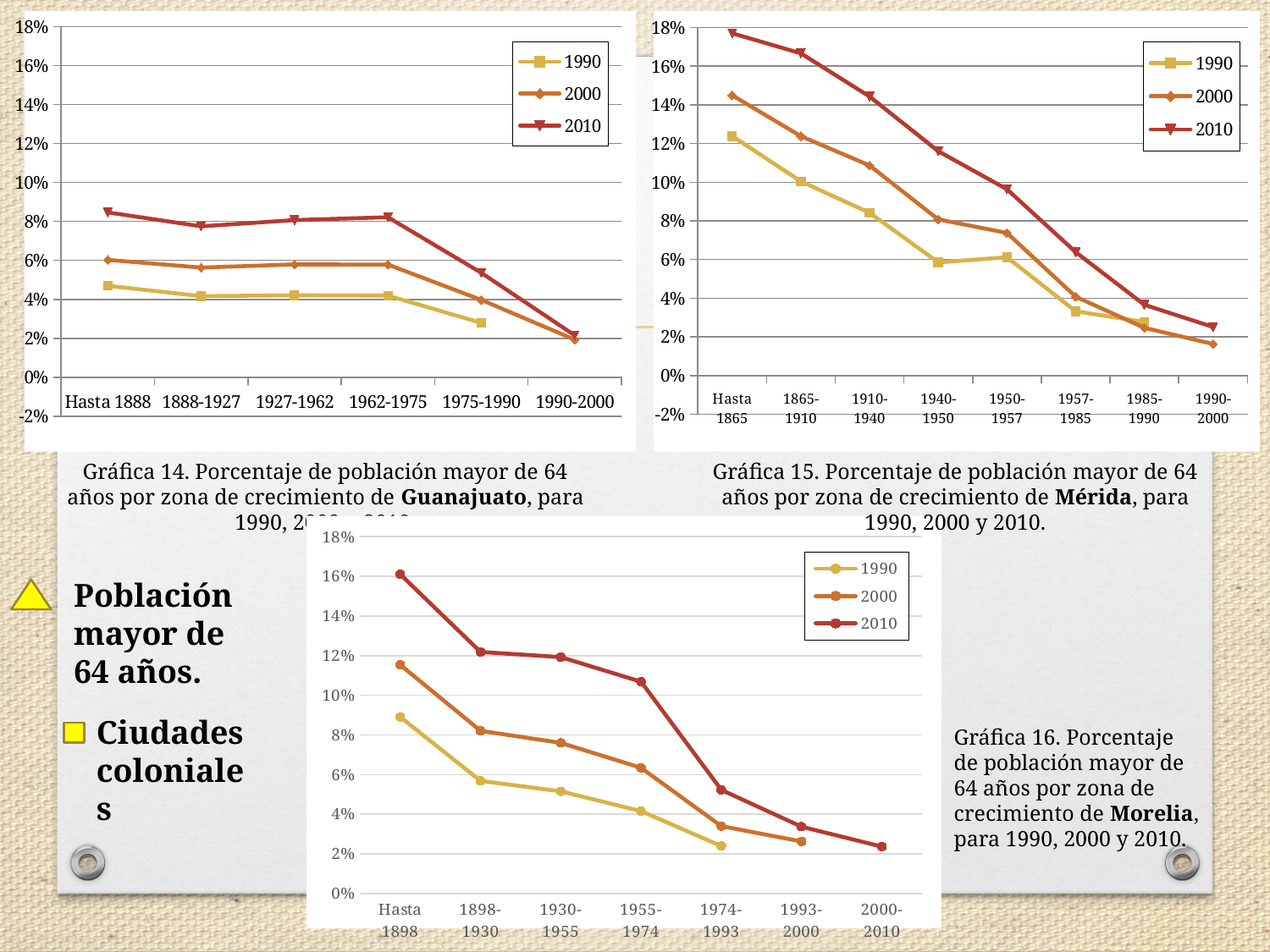
What type of chart is Gráfica 14 (Guanajuato)? Line chart How many categories are shown on the x axis of Gráfica 16 (Morelia)? 7 How many categories are shown on the x axis of Gráfica 14 (Guanajuato)? 6 In Gráfica 15 (Mérida), is the 2010 value for Hasta 1865 greater or less than 16%? greater In Gráfica 14 (Guanajuato), is the 2010 value for Hasta 1888 greater or less than 8%? greater How many series does the legend of Gráfica 15 (Mérida) list? 3 How many categories are shown on the x axis of Gráfica 15 (Mérida)? 8 In Gráfica 16 (Morelia), is the 1990 value for Hasta 1898 greater or less than 8%? greater In Gráfica 15 (Mérida), do the 2010 values rise or fall from Hasta 1865 to 1990-2000? Fall In Gráfica 15 (Mérida), which category has the highest 2010 value? Hasta 1865 In Gráfica 16 (Morelia), which is larger for 1898-1930: the 2010 value or the 1990 value? 2010